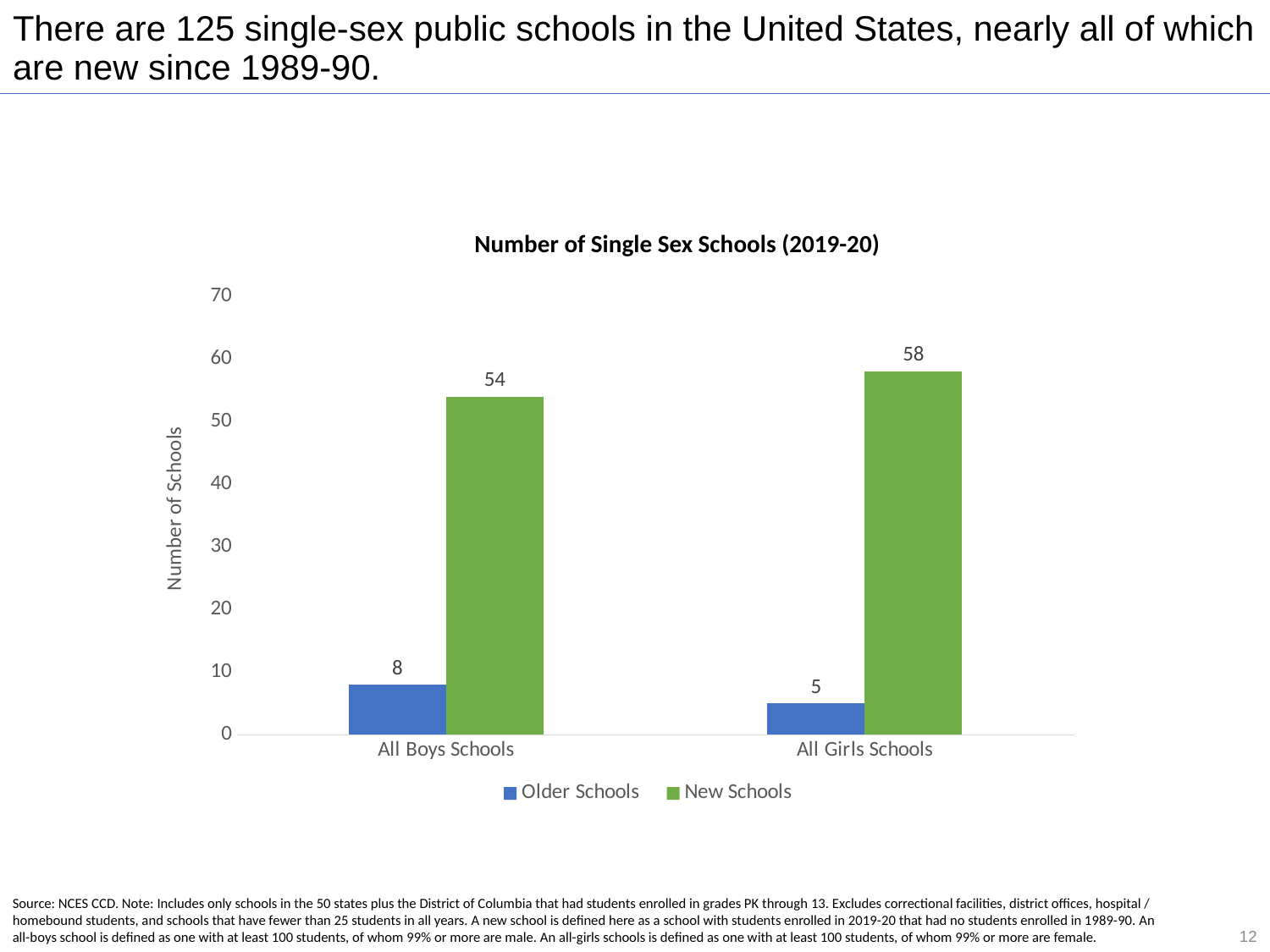
What is the number of Older Schools for All Girls Schools? 5 Which category has the highest value for New Schools? All Girls Schools What is the number of Older Schools for All Boys Schools? 8 How many categories are shown on the x axis? 2 What is the number of New Schools for All Boys Schools? 54 What is the title of the chart? Number of Single Sex Schools (2019-20) How many series does the legend list? 2 What is the number of New Schools for All Girls Schools? 58 Which category has the lowest value for Older Schools? All Girls Schools What kind of chart is shown on the slide? Bar chart What is the difference between New Schools and Older Schools for All Boys Schools? 46 Which is larger: Older Schools for All Boys Schools or Older Schools for All Girls Schools? All Boys Schools